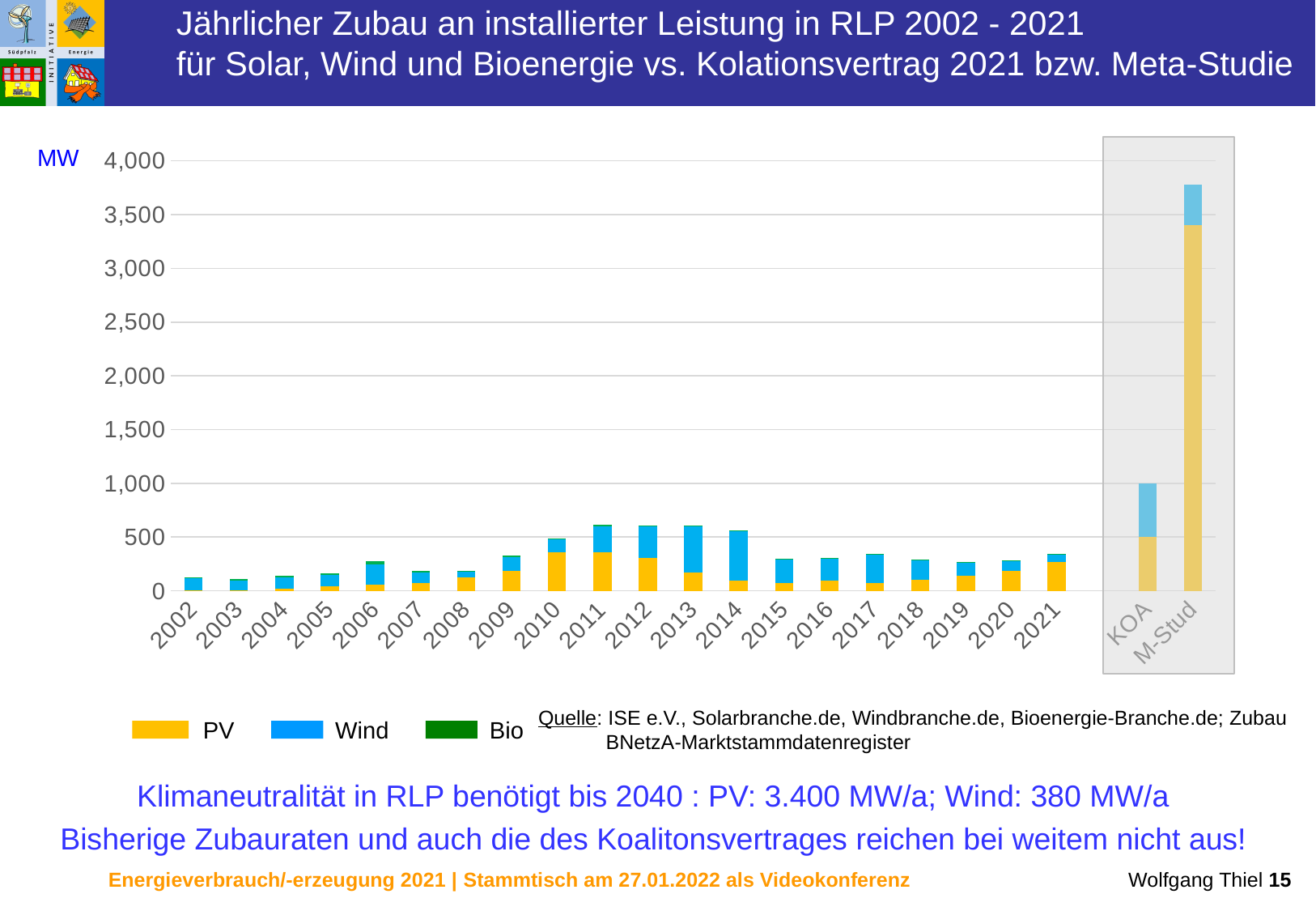
Which series are listed in the chart legend? PV, Wind, Bio Is the total value for 2011 greater or less than 500? greater What kind of chart is shown on the slide? stacked bar chart Do the total bar values rise or fall from 2013 to 2015? fall Is the total value for 2002 greater or less than 500? less What unit is shown on the y axis of the chart? MW How many categories are shown on the x axis of the chart (years plus the two comparison bars)? 22 Which category has the highest total bar in the chart? M-Stud How many series does the chart legend list? 3 Is the total value for KOA greater or less than 500? greater Which has the larger total bar, 2011 or 2015? 2011